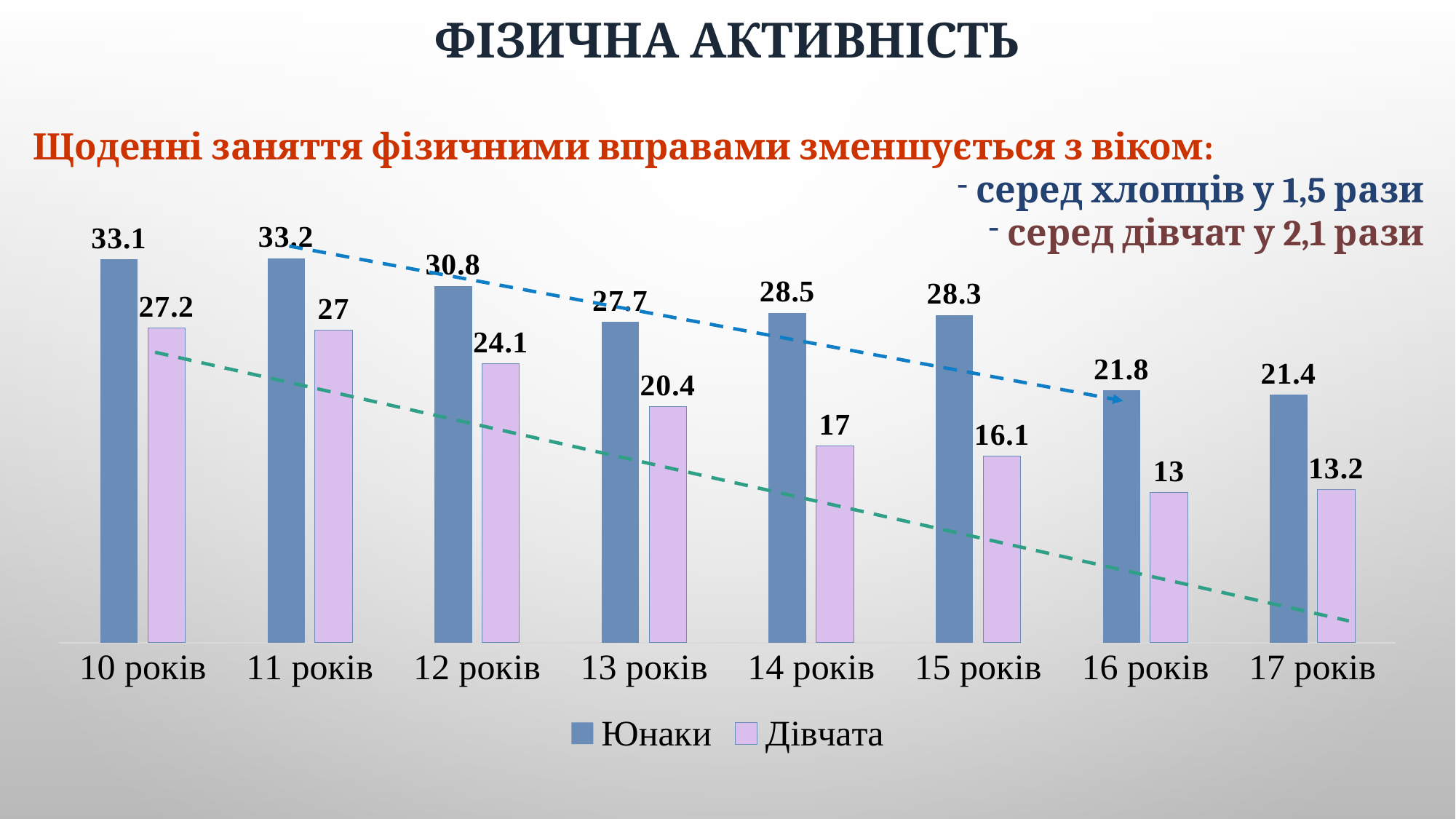
What is the value for Юнаки at 10 років? 33.1 How many age groups are shown on the x axis? 8 At which age group is the Юнаки value highest? 11 років Do the Дівчата values generally rise or fall from 10 років to 17 років? fall How many series does the legend list? 2 What is the difference between the Юнаки and Дівчата values at 14 років? 11.5 At which age group is the Дівчата value lowest? 16 років What is the value for Дівчата at 15 років? 16.1 What is the value for Дівчата at 17 років? 13.2 Which is larger at 12 років: Юнаки or Дівчата? Юнаки What are the two series named in the legend? Юнаки and Дівчата What kind of chart is shown on the slide? bar chart